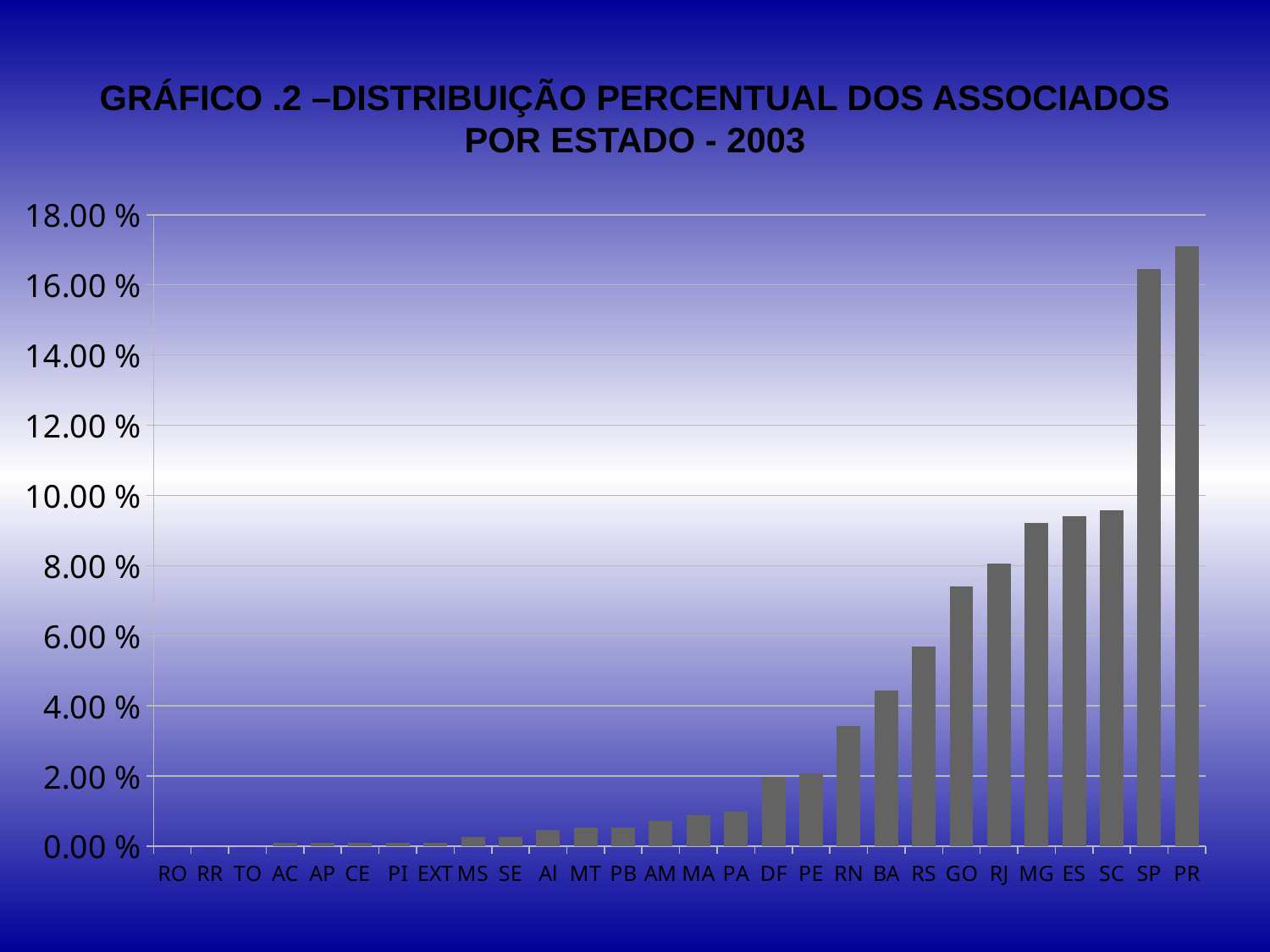
How many states (categories) are plotted along the x axis? 28 Is the value for RN greater or less than 4.00 %? less Which state has the highest percentage of associados? PR Is the value for SC greater or less than 10.00 %? less What kind of chart is shown on the slide? bar chart Is the value for RS greater or less than 6.00 %? less What year does the chart title refer to? 2003 Do the values generally rise or fall moving from left to right along the x axis? rise Which has a larger value, SP or MG? SP